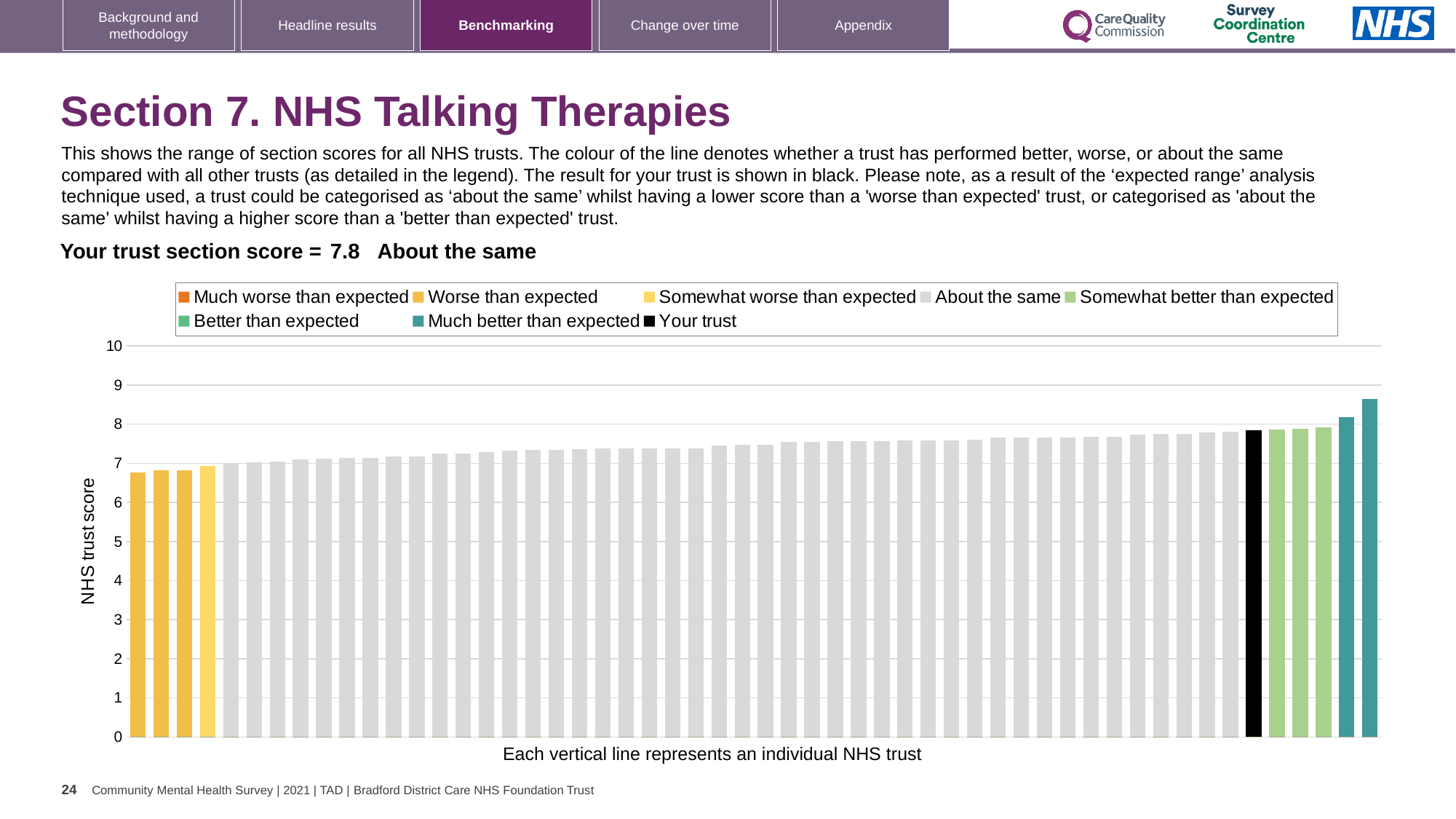
How many entries does the chart legend list? 8 Is the value of the tallest bar greater or less than 8? greater What is the section score for your trust? 7.8 How many bars are coloured 'Much better than expected' (teal)? 2 What is the label on the y axis? NHS trust score What kind of chart is shown on the slide? bar chart Is the value for your trust's bar greater or less than 7? greater What colour is the bar for your trust? black Is the value of the shortest bar greater or less than 7? less Which is larger: the value of your trust's bar or the value of the tallest bar? the tallest bar Which legend category does the tallest bar belong to? Much better than expected Do the bar values rise or fall from left to right along the x axis? rise